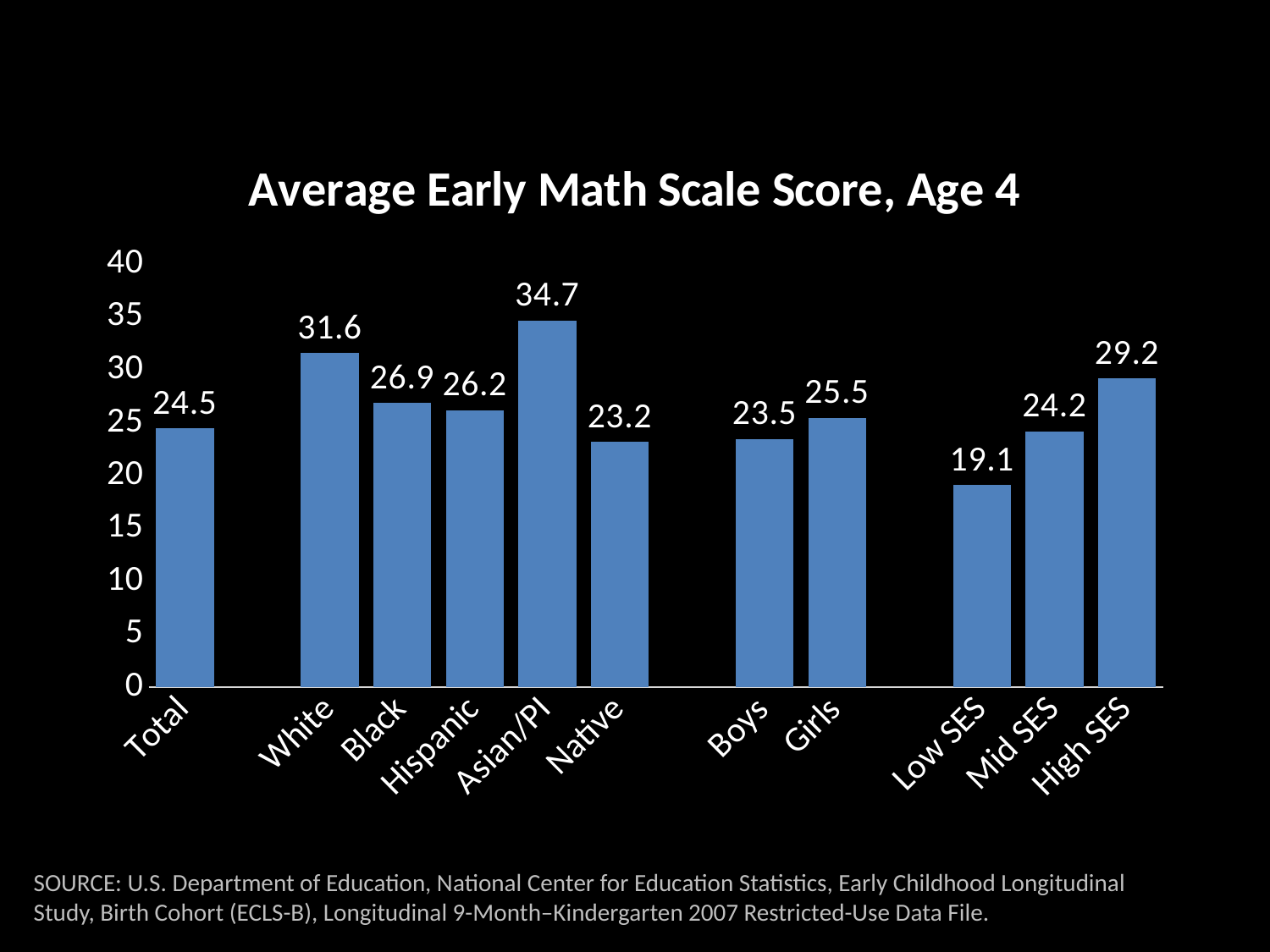
What is the difference between the scores for High SES and Low SES? 10.1 What is the average early math scale score for Asian/PI children? 34.7 How many categories are shown on the x axis? 11 What kind of chart is shown on the slide? bar chart What is the value shown for Low SES? 19.1 Is the value for Native greater or less than 25? less Which category has the highest average early math scale score? Asian/PI What is the title of the chart? Average Early Math Scale Score, Age 4 Which category has the lowest average early math scale score? Low SES Which is larger, the score for Boys or the score for Girls? Girls What is the difference between the scores for White and Black children? 4.7 What is the value shown for Girls? 25.5